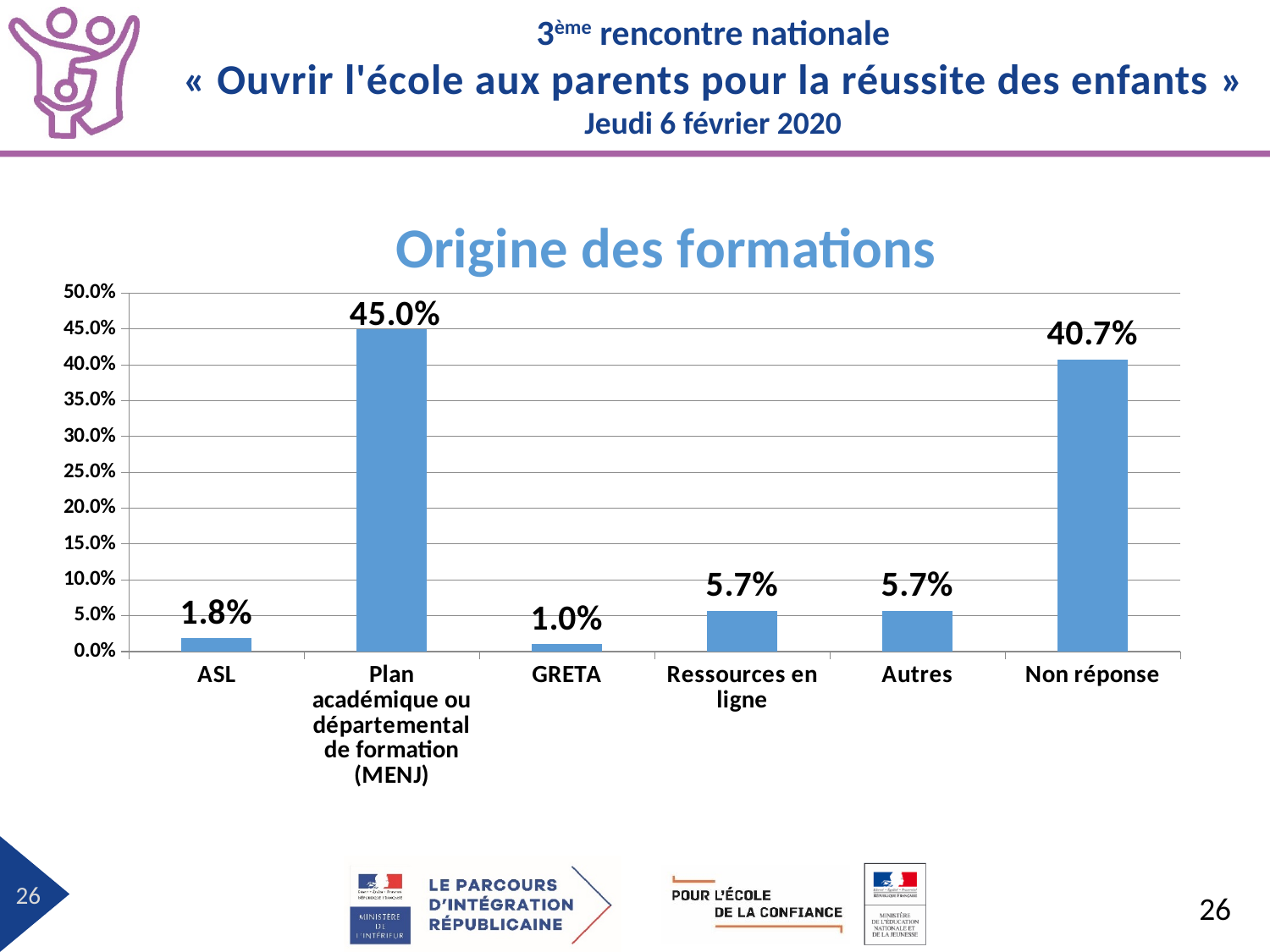
What is the value for Ressources en ligne? 5.7% Which category has the highest value? Plan académique ou départemental de formation (MENJ) What is the difference between the values for Plan académique ou départemental de formation (MENJ) and Non réponse? 4.3% What is the value for Non réponse? 40.7% How many categories are shown on the x axis? 6 Is the value for Non réponse greater or less than 35.0%? greater What is the value for GRETA? 1.0% Which is larger, the value for ASL or the value for GRETA? ASL Which category has the lowest value? GRETA What is the value for ASL? 1.8% What is the title of the chart? Origine des formations What kind of chart is this? Bar chart